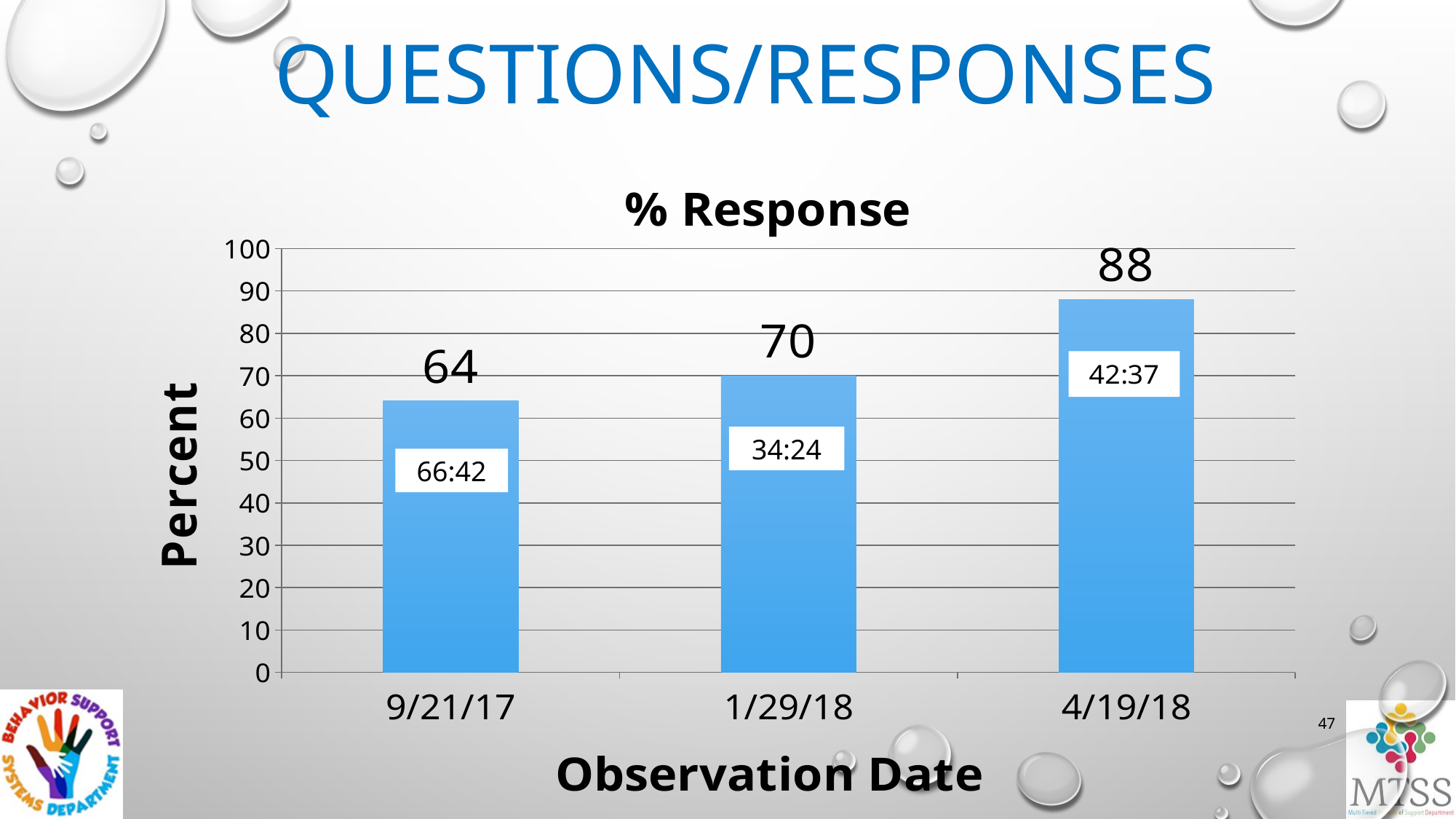
What is the % Response value for 9/21/17? 64 Which observation date has the highest % Response? 4/19/18 Which has a higher % Response, 1/29/18 or 4/19/18? 4/19/18 What is the % Response value for 1/29/18? 70 How many observation dates are shown on the chart? 3 What is the label on the y axis of the chart? Percent What kind of chart is shown on the slide? Bar chart Which observation date has the lowest % Response? 9/21/17 What is the difference in % Response between 4/19/18 and 9/21/17? 24 What is the difference in % Response between 1/29/18 and 9/21/17? 6 Do the % Response values rise or fall across the observation dates from 9/21/17 to 4/19/18? Rise What is the % Response value for 4/19/18? 88